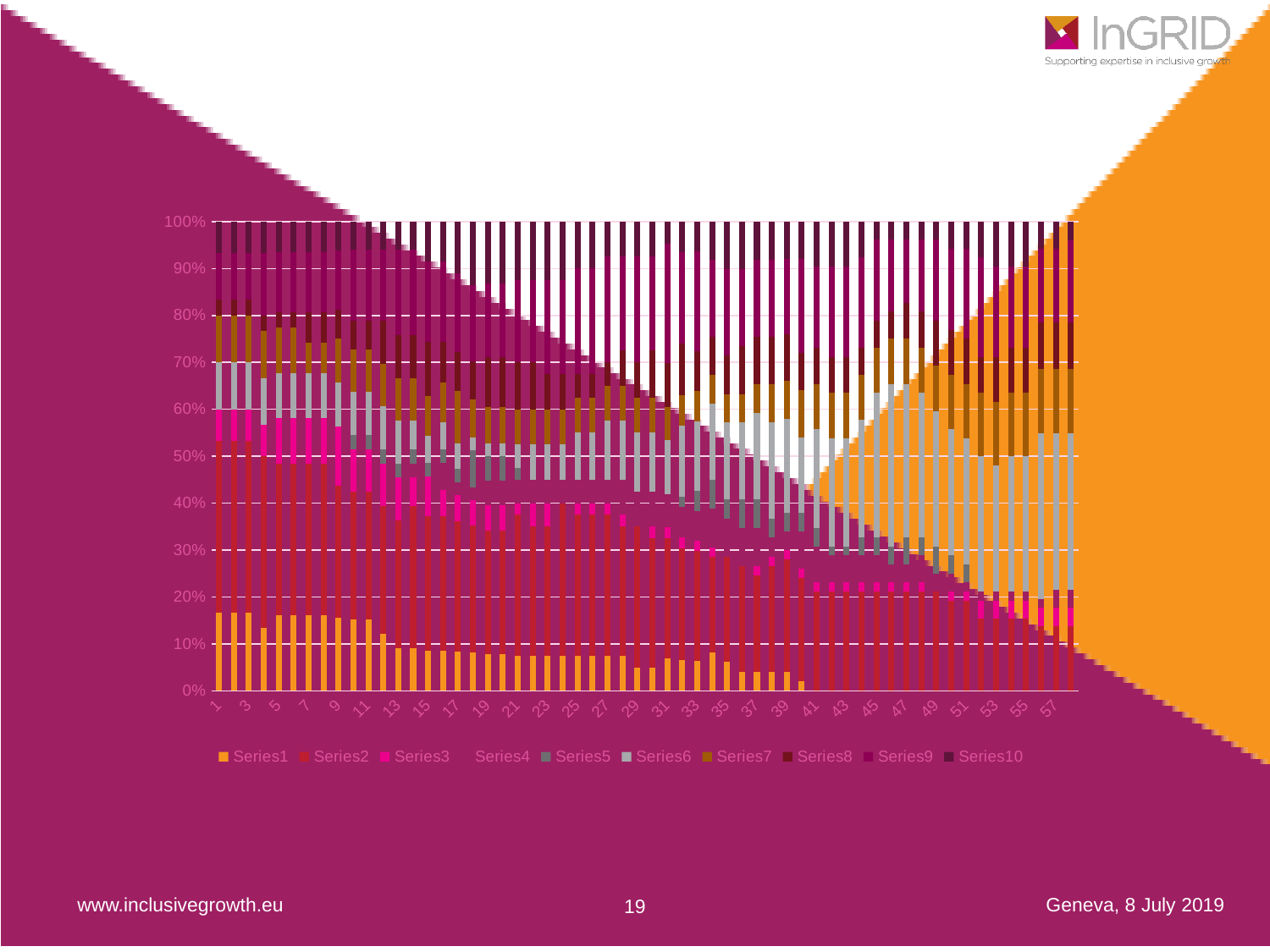
What is the name of the first series listed in the legend? Series1 Is the value for Series1 at category 1 greater or less than 20%? less Is the Series2 segment at category 1 greater or less than 20 percentage points tall? greater How many series does the legend list? 10 Does the Series1 segment (bottom of the bars) rise or fall as you move from category 1 to category 57 along the x axis? fall What is the total height of each stacked bar, as shown by the top of the y axis? 100% What is the highest value shown on the y axis? 100% What is the last category label shown on the x axis? 57 Which is larger, the Series1 segment at category 1 or the Series1 segment at category 39? Category 1 What kind of chart is shown on the slide? Stacked bar chart Is the value for Series1 at category 1 greater or less than 10%? greater